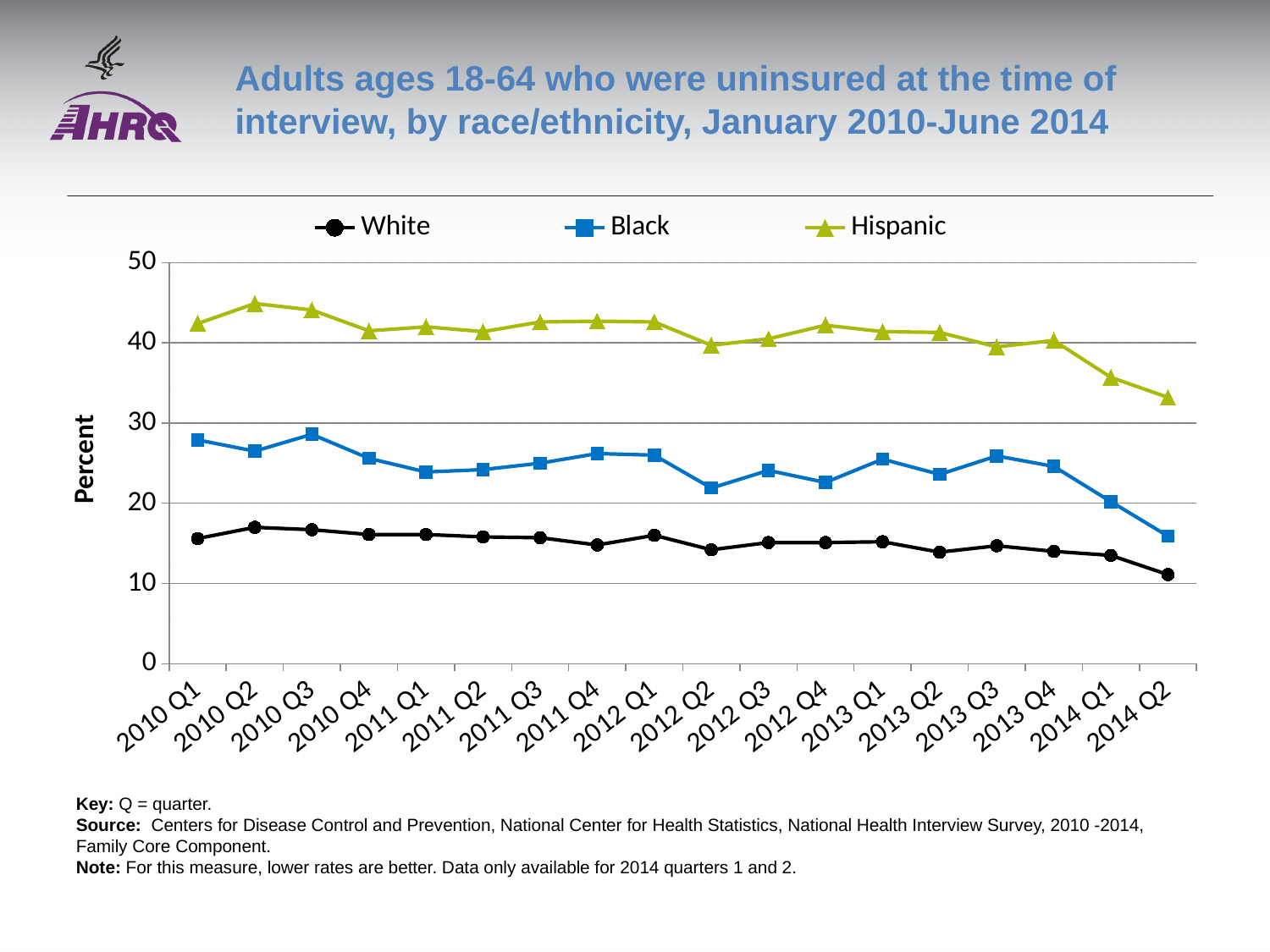
How many quarters are plotted along the x axis? 18 Which race/ethnicity group has the lowest uninsured rate across the period? White How many series does the legend list? 3 Is the value for White in 2014 Q2 greater or less than 20? less Does the Hispanic line rise or fall from 2013 Q4 to 2014 Q2? fall Which race/ethnicity group has the highest uninsured rate across the period? Hispanic What is the label on the y axis? Percent Which is larger in 2012 Q1, the value for Hispanic or the value for Black? Hispanic Is the value for Black in 2014 Q2 greater or less than 20? less Is the value for Hispanic in 2010 Q2 greater or less than 40? greater What kind of chart is shown on the slide? line chart